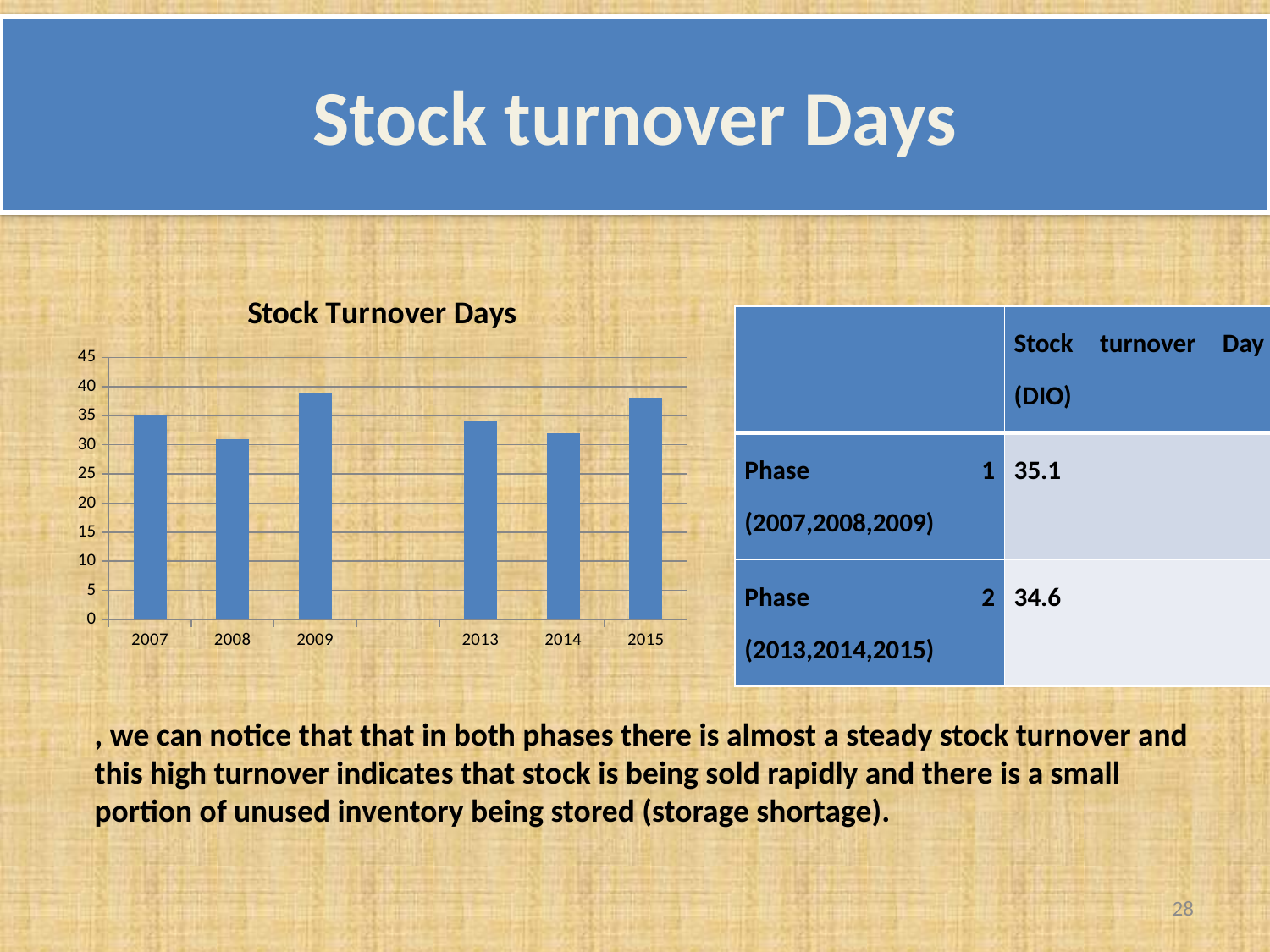
How many years are plotted in the chart? 6 Is the value for 2009 greater or less than 35? greater What kind of chart is shown on the slide? bar chart Which year has the larger value, 2008 or 2009? 2009 Is the value for 2007 greater or less than 30? greater Which year has the larger value, 2014 or 2015? 2015 Is the value for 2014 greater or less than 35? less Which year has the larger value, 2007 or 2008? 2007 What is the title of the chart? Stock Turnover Days